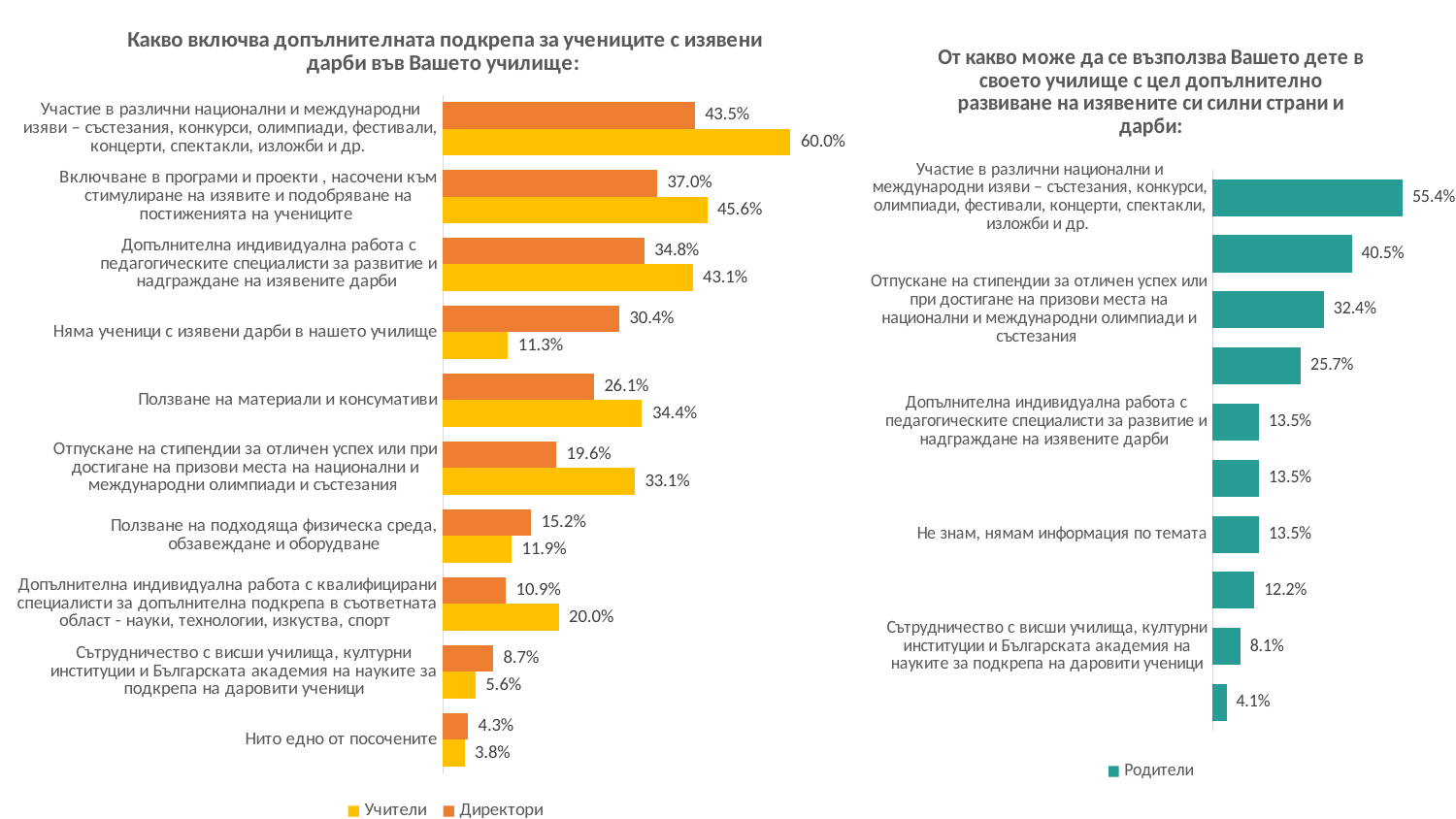
In the left chart, which category has the highest value for Учители? Участие в различни национални и международни изяви – състезания, конкурси, олимпиади, фестивали, концерти, спектакли, изложби и др. How many series does the legend of the left chart list? 2 In the left chart ("Какво включва допълнителната подкрепа за учениците с изявени дарби във Вашето училище"), what is the value for Учители for "Няма ученици с изявени дарби в нашето училище"? 11.3% In the right chart, what is the lowest value shown? 4.1% In the right chart ("От какво може да се възползва Вашето дете..."), what is the highest value shown? 55.4% In the left chart, what is the value for Директори for "Ползване на материали и консумативи"? 26.1% Which series does the legend of the right chart list? Родители How many categories are shown in the left chart? 10 What type of chart is the left chart? Bar chart In the left chart, what is the difference between the Учители and Директори values for "Участие в различни национални и международни изяви"? 16.5 percentage points In the left chart, for "Ползване на подходяща физическа среда, обзавеждане и оборудване", which series has the larger value, Учители or Директори? Директори In the left chart, which category has the lowest value for Директори? Нито едно от посочените